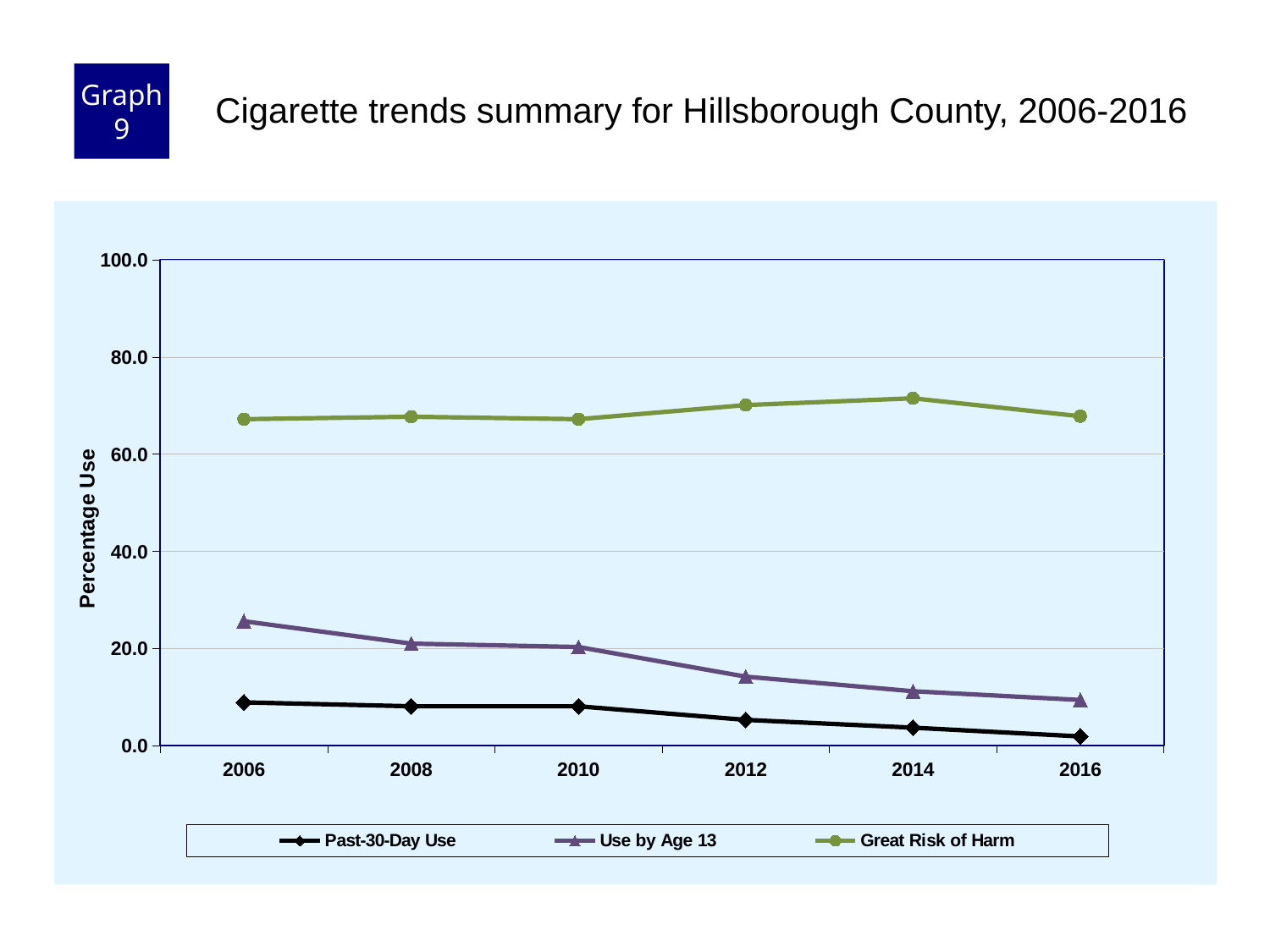
How many series does the legend list? 3 Is the value for Great Risk of Harm in 2014 greater or less than 60.0? greater What is the label on the y axis? Percentage Use Does the Use by Age 13 line rise or fall from 2006 to 2016? Falls Is the value for Use by Age 13 in 2016 greater or less than 20.0? less In which year is the Use by Age 13 value highest? 2006 In which year is the Past-30-Day Use value lowest? 2016 How many years are plotted along the x axis? 6 Is the value for Use by Age 13 in 2006 greater or less than 20.0? greater Which series has the highest value in 2016? Great Risk of Harm What kind of chart is shown on the slide? Line chart Does the Past-30-Day Use line rise or fall from 2006 to 2016? Falls